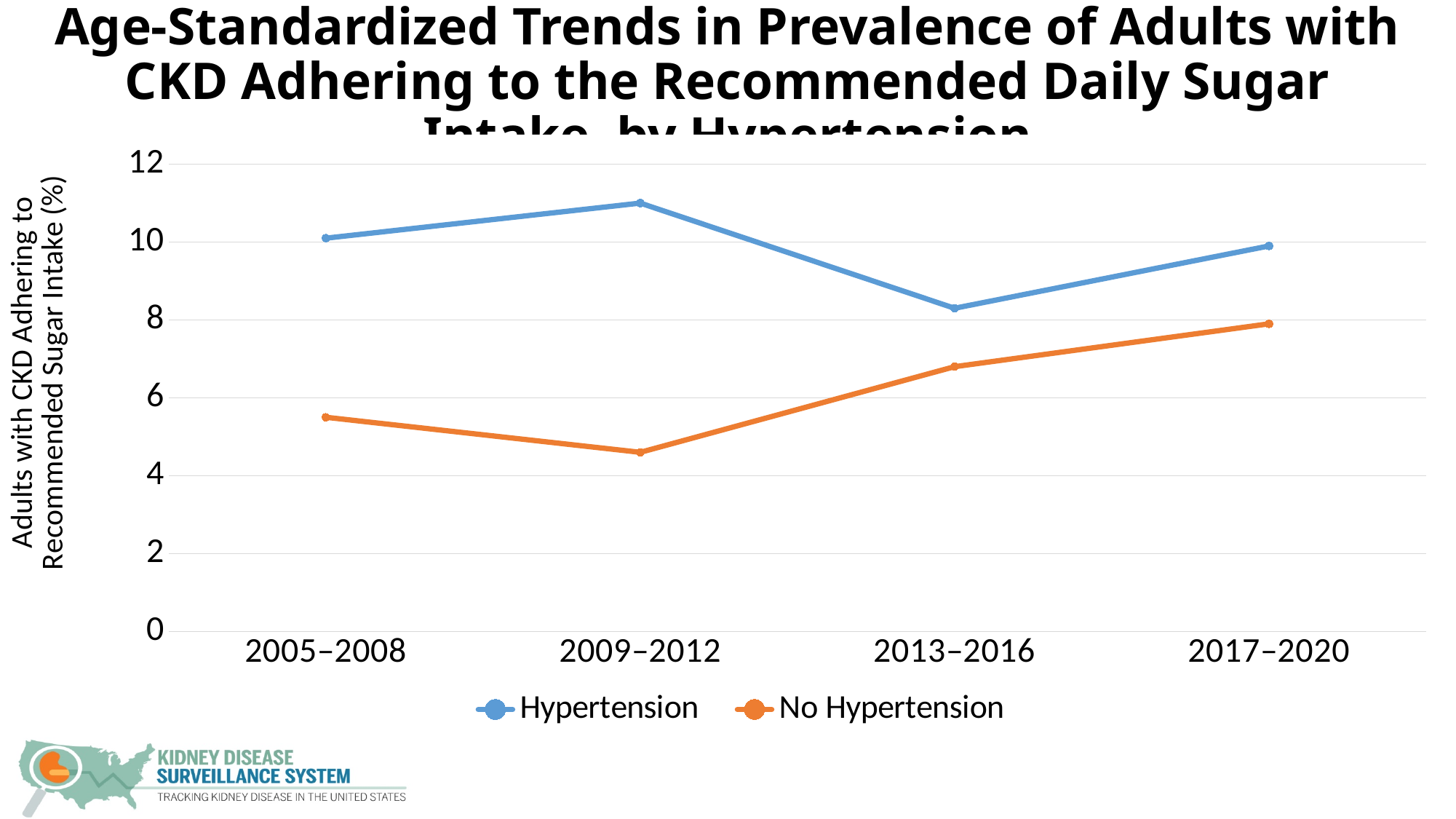
Is the value for Hypertension in 2009–2012 greater or less than 10? greater How many series does the legend list? 2 Does the No Hypertension series rise or fall from 2009–2012 to 2017–2020? Rise How many time periods are shown on the x axis? 4 In which period is the Hypertension series highest? 2009–2012 Is the value for Hypertension in 2013–2016 greater or less than 10? less In 2005–2008, which series has the larger value, Hypertension or No Hypertension? Hypertension In which period is the No Hypertension series lowest? 2009–2012 In which period is the No Hypertension series highest? 2017–2020 Is the value for No Hypertension in 2009–2012 greater or less than 6? less In which period is the Hypertension series lowest? 2013–2016 What kind of chart is shown on the slide? Line chart